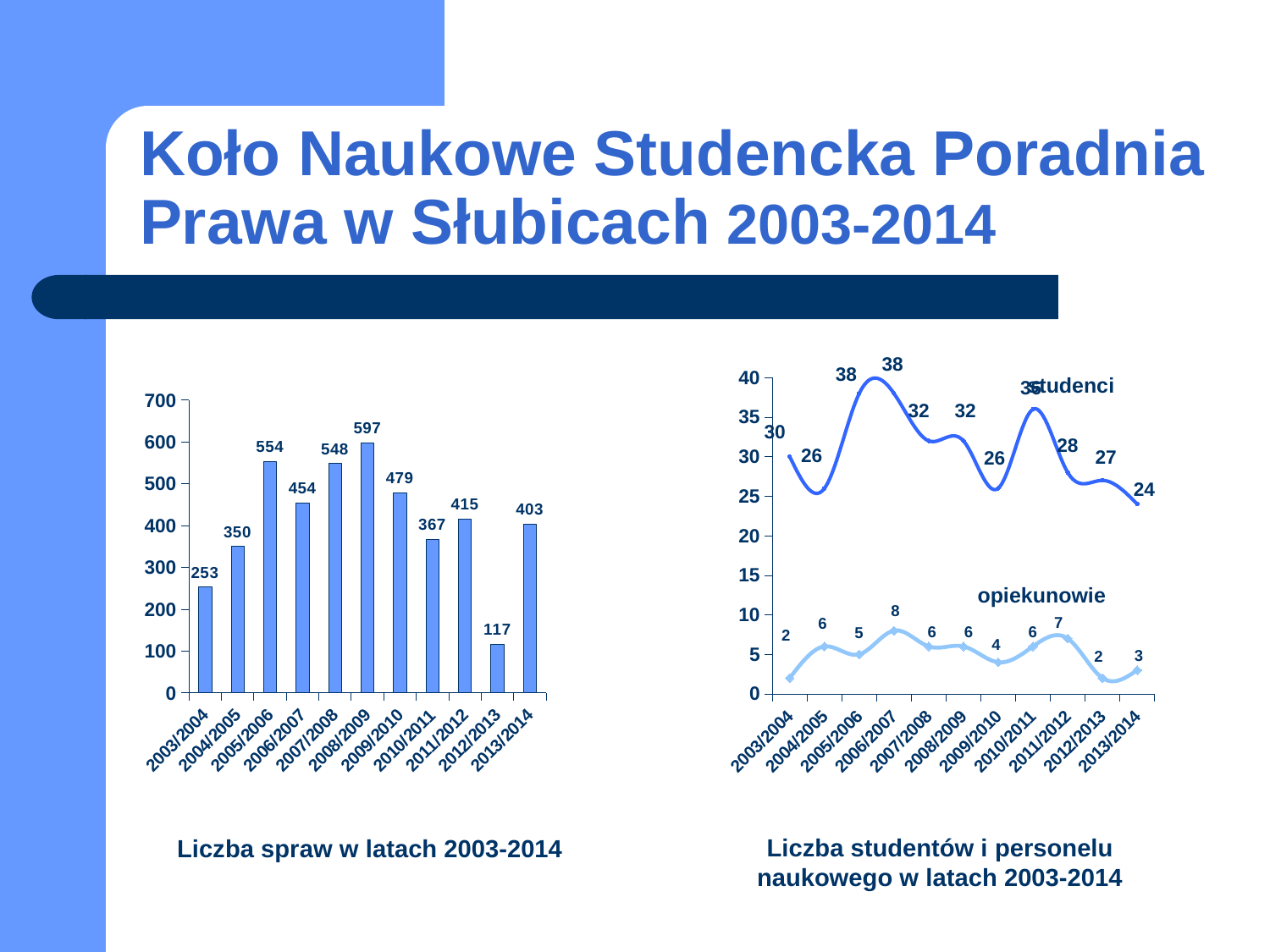
How many years are shown in the chart 'Liczba spraw w latach 2003-2014'? 11 In the chart 'Liczba studentów i personelu naukowego w latach 2003-2014', what is the value for studenci in 2005/2006? 38 What kind of chart is 'Liczba spraw w latach 2003-2014'? bar chart In the chart 'Liczba studentów i personelu naukowego w latach 2003-2014', what is the value for opiekunowie in 2006/2007? 8 In the chart 'Liczba spraw w latach 2003-2014', which is larger, the value for 2010/2011 or the value for 2011/2012? 2011/2012 In the chart 'Liczba spraw w latach 2003-2014', which year has the highest value? 2008/2009 In the chart 'Liczba spraw w latach 2003-2014', what is the value for 2008/2009? 597 What kind of chart is 'Liczba studentów i personelu naukowego w latach 2003-2014'? line chart How many series are plotted in the chart 'Liczba studentów i personelu naukowego w latach 2003-2014'? 2 In the chart 'Liczba spraw w latach 2003-2014', which year has the lowest value? 2012/2013 In the chart 'Liczba studentów i personelu naukowego w latach 2003-2014', what is the difference between studenci and opiekunowie in 2013/2014? 21 In the chart 'Liczba spraw w latach 2003-2014', what is the difference between the values for 2005/2006 and 2004/2005? 204